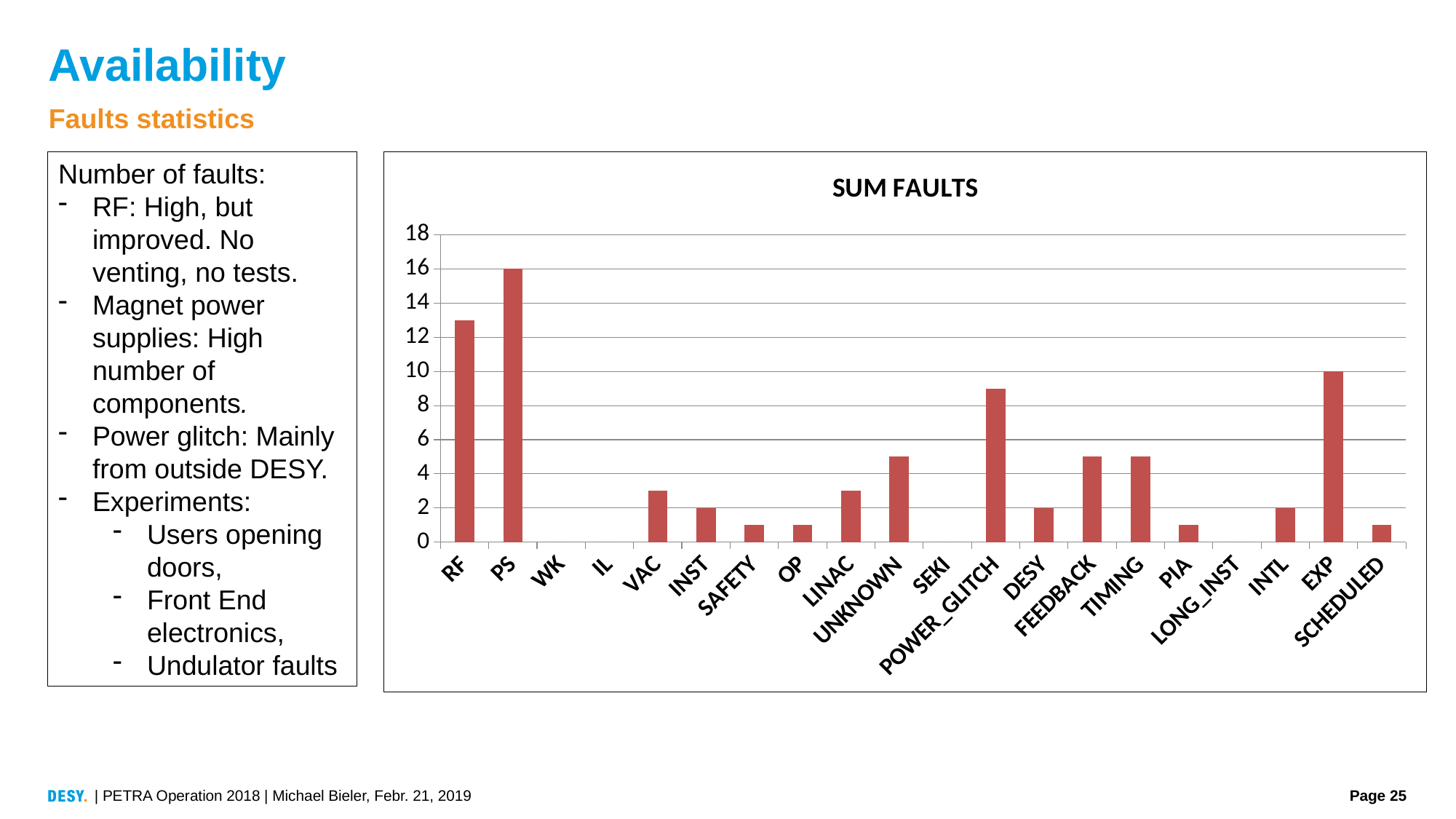
What is the title of the chart? SUM FAULTS What is the value for PS? 16 How many categories are shown on the x axis of the chart? 20 Is the value for RF greater or less than 12? greater Is the value for UNKNOWN greater or less than 4? greater What is the value for EXP? 10 What type of chart is shown on the slide? bar chart Which category has the highest number of faults? PS What is the difference between the values for PS and EXP? 6 Which is larger, the value for POWER_GLITCH or the value for FEEDBACK? POWER_GLITCH Which is larger, the value for RF or the value for EXP? RF Is the value for POWER_GLITCH greater or less than 10? less